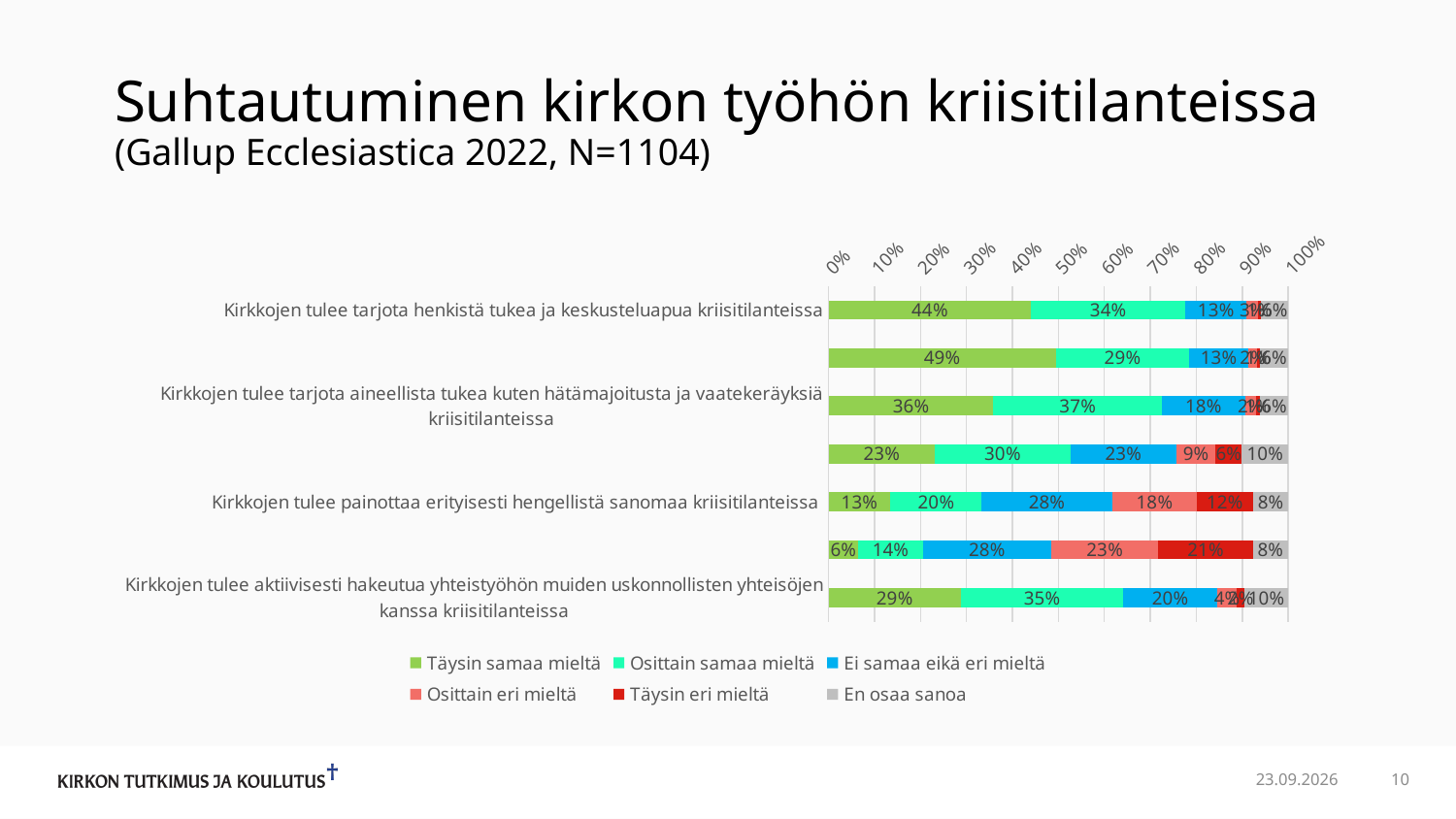
What percentage answered 'Osittain eri mieltä' to 'Kirkkojen tulee painottaa erityisesti hengellistä sanomaa kriisitilanteissa'? 18% What kind of chart is shown on the slide? Stacked bar chart What percentage answered 'Osittain samaa mieltä' to 'Kirkkojen tulee aktiivisesti hakeutua yhteistyöhön muiden uskonnollisten yhteisöjen kanssa kriisitilanteissa'? 35% What percentage answered 'Täysin samaa mieltä' to 'Kirkkojen tulee painottaa erityisesti hengellistä sanomaa kriisitilanteissa'? 13% What percentage answered 'Ei samaa eikä eri mieltä' to 'Kirkkojen tulee painottaa erityisesti hengellistä sanomaa kriisitilanteissa'? 28% What percentage answered 'Täysin samaa mieltä' to 'Kirkkojen tulee tarjota henkistä tukea ja keskusteluapua kriisitilanteissa'? 44% Which statement has the larger 'Täysin samaa mieltä' share: 'Kirkkojen tulee tarjota henkistä tukea ja keskusteluapua kriisitilanteissa' or 'Kirkkojen tulee painottaa erityisesti hengellistä sanomaa kriisitilanteissa'? Kirkkojen tulee tarjota henkistä tukea ja keskusteluapua kriisitilanteissa What percentage answered 'En osaa sanoa' to 'Kirkkojen tulee aktiivisesti hakeutua yhteistyöhön muiden uskonnollisten yhteisöjen kanssa kriisitilanteissa'? 10% How many series does the legend list? 6 What is the difference in 'Täysin samaa mieltä' share between 'Kirkkojen tulee tarjota henkistä tukea ja keskusteluapua kriisitilanteissa' and 'Kirkkojen tulee painottaa erityisesti hengellistä sanomaa kriisitilanteissa'? 31 percentage points Which legend entry is shown in red? Täysin eri mieltä What percentage answered 'Osittain samaa mieltä' to 'Kirkkojen tulee tarjota henkistä tukea ja keskusteluapua kriisitilanteissa'? 34%